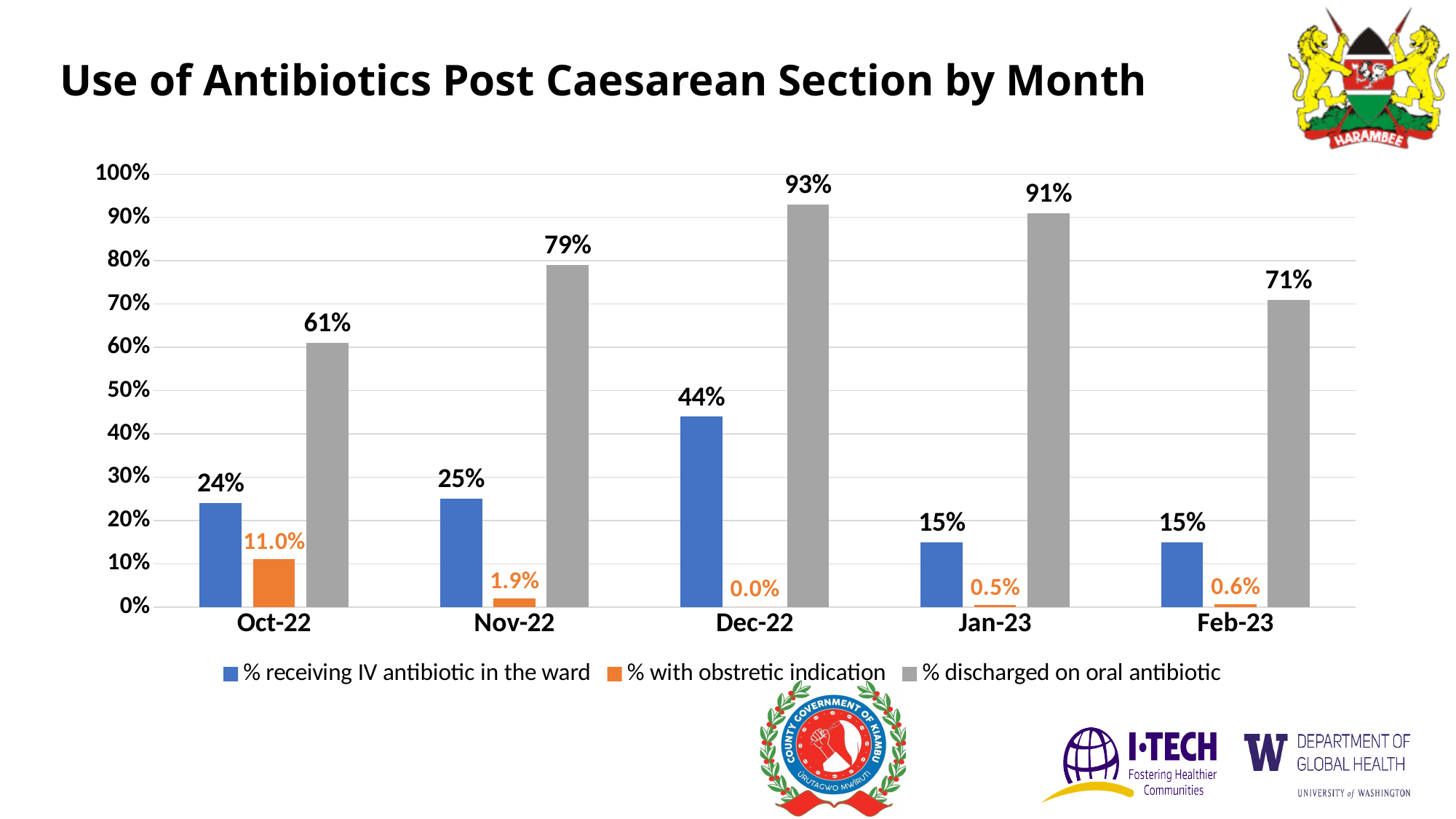
In which month was the % discharged on oral antibiotic highest? Dec-22 What is the value for % with obstetric indication in Nov-22? 1.9% What percentage of patients were receiving IV antibiotic in the ward in Oct-22? 24% Which colour represents % with obstetric indication in the legend? Orange What kind of chart is shown on the slide? Bar chart How many months are shown on the x axis? 5 Which is larger: the % receiving IV antibiotic in the ward in Dec-22 or in Nov-22? Dec-22 What is the difference between the % discharged on oral antibiotic in Dec-22 and in Oct-22? 32% In which month was the % with obstetric indication lowest? Dec-22 How many series does the legend list? 3 Does the % discharged on oral antibiotic rise or fall from Oct-22 to Dec-22? Rise What percentage of patients were discharged on oral antibiotic in Dec-22? 93%